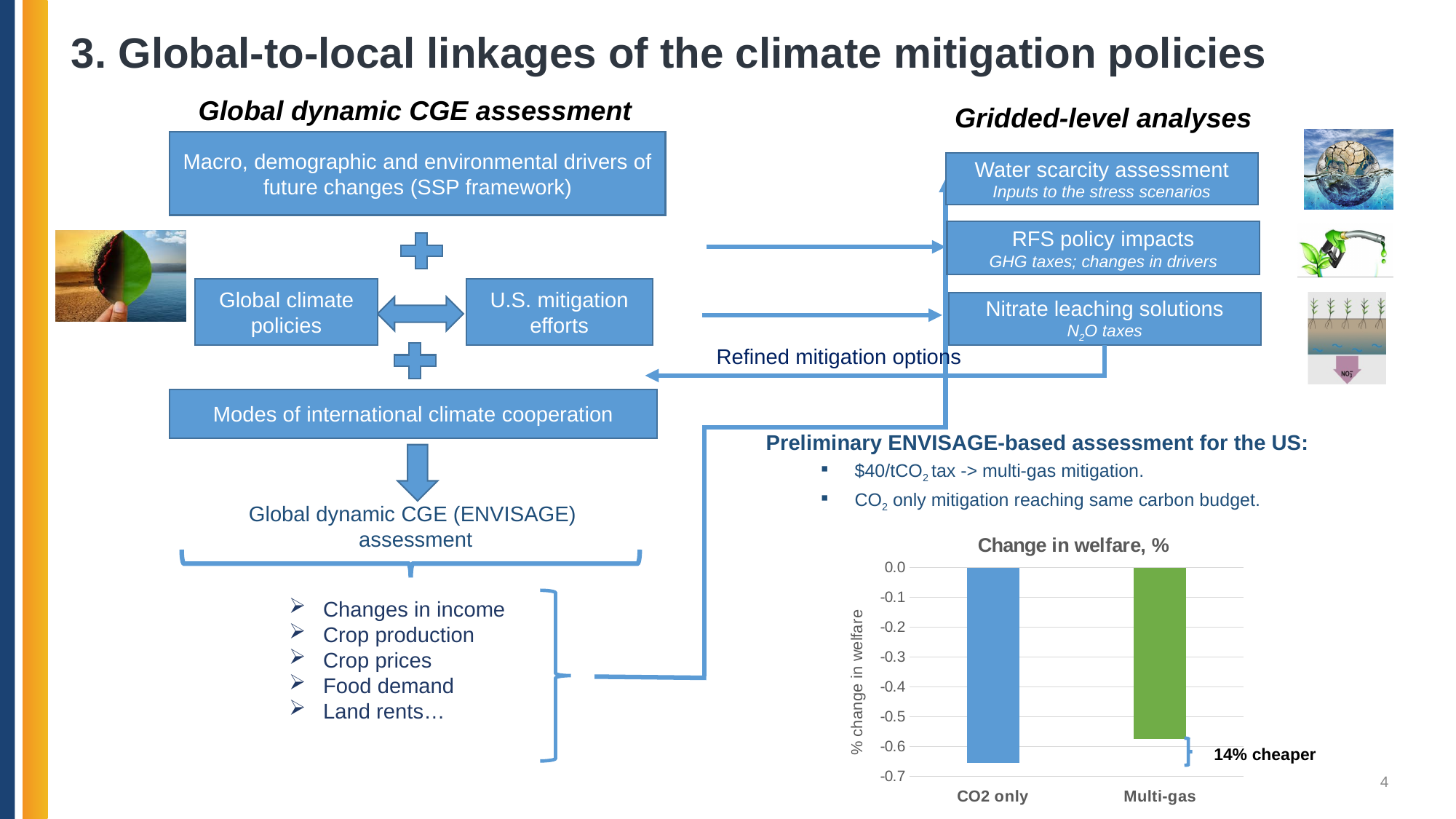
In the 'Change in welfare, %' chart, is the value for Multi-gas greater or less than -0.6? greater What annotation is written next to the Multi-gas bar in the 'Change in welfare, %' chart? 14% cheaper How many categories are plotted in the 'Change in welfare, %' chart? 2 In the 'Change in welfare, %' chart, which category has the higher (less negative) value? Multi-gas In the 'Change in welfare, %' chart, is the value for Multi-gas greater or less than -0.5? less What kind of chart is shown under 'Change in welfare, %'? bar chart What is the label of the vertical axis in the 'Change in welfare, %' chart? % change in welfare In the 'Change in welfare, %' chart, which bar is larger in value, CO2 only or Multi-gas? Multi-gas In the 'Change in welfare, %' chart, is the value for CO2 only greater or less than -0.6? less In the 'Change in welfare, %' chart, which category has the lowest (most negative) value? CO2 only What is the lowest tick value shown on the vertical axis of the 'Change in welfare, %' chart? -0.7 What is the title of the chart on the slide? Change in welfare, %